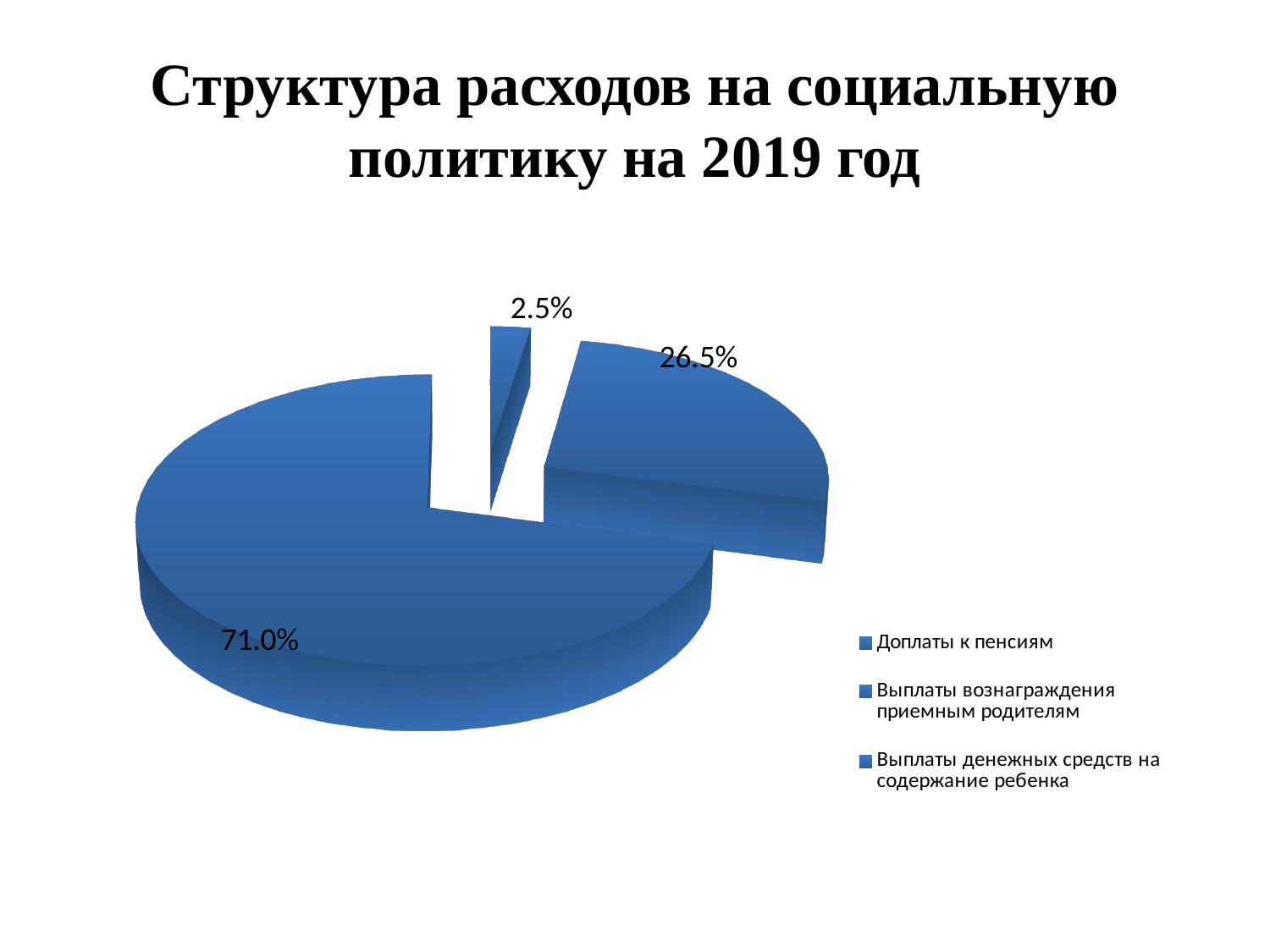
Which is larger: the slice labelled 26.5% or the slice labelled 2.5%? 26.5% What is the difference between the largest slice (71.0%) and the second-largest slice (26.5%)? 44.5% How many entries does the legend list? 3 What is the title of the chart on the slide? Структура расходов на социальную политику на 2019 год What is the first entry listed in the chart legend? Доплаты к пенсиям What is the share of the largest slice in the pie chart? 71.0% What is the difference between the 26.5% slice and the 2.5% slice? 24.0% Is the largest slice of the pie greater or less than 50%? greater What kind of chart is shown on the slide? pie chart How many slices does the pie chart have? 3 What is the total of the three slice percentages shown on the pie chart? 100.0% What is the share of the smallest slice in the pie chart? 2.5%